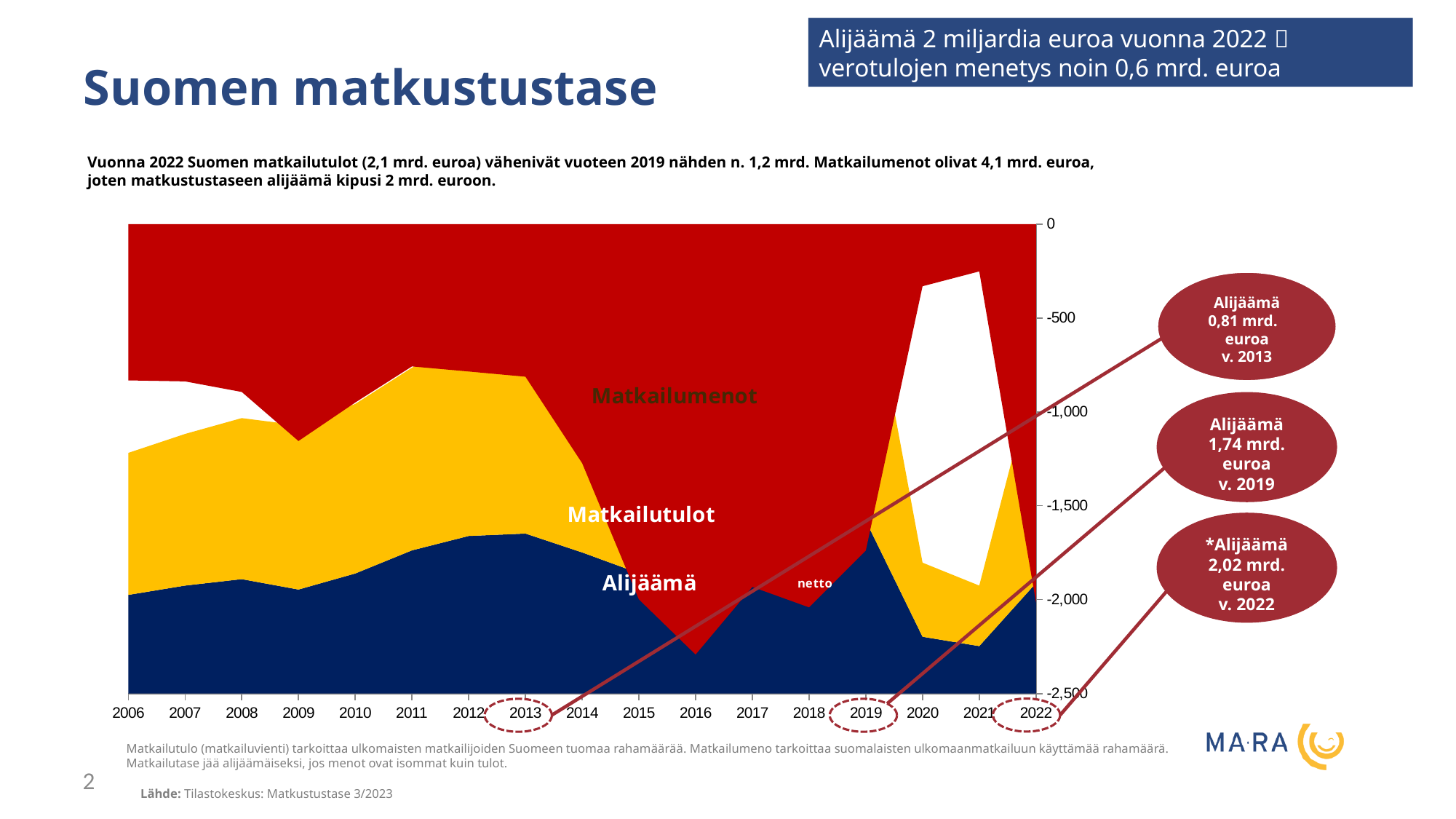
What is the lowest value shown on the y axis of the chart? -2,500 Which is larger according to the callouts: the Alijäämä in 2013 or in 2019? 2019 Of the three years with callouts (2013, 2019, 2022), which has the smallest Alijäämä? 2013 What is the last year shown on the x axis? 2022 According to the callout, what was the Alijäämä (deficit) in 2022? 2,02 mrd. euroa What is the first year shown on the x axis? 2006 How many years are shown on the x axis of the chart? 17 What kind of chart is shown on the slide? Area chart Of the three years with callouts (2013, 2019, 2022), which has the largest Alijäämä? 2022 According to the callout, what was the Alijäämä (deficit) in 2013? 0,81 mrd. euroa According to the callout, what was the Alijäämä (deficit) in 2019? 1,74 mrd. euroa By how much did the Alijäämä in 2022 exceed the Alijäämä in 2019, according to the callouts? 0,28 mrd. euroa